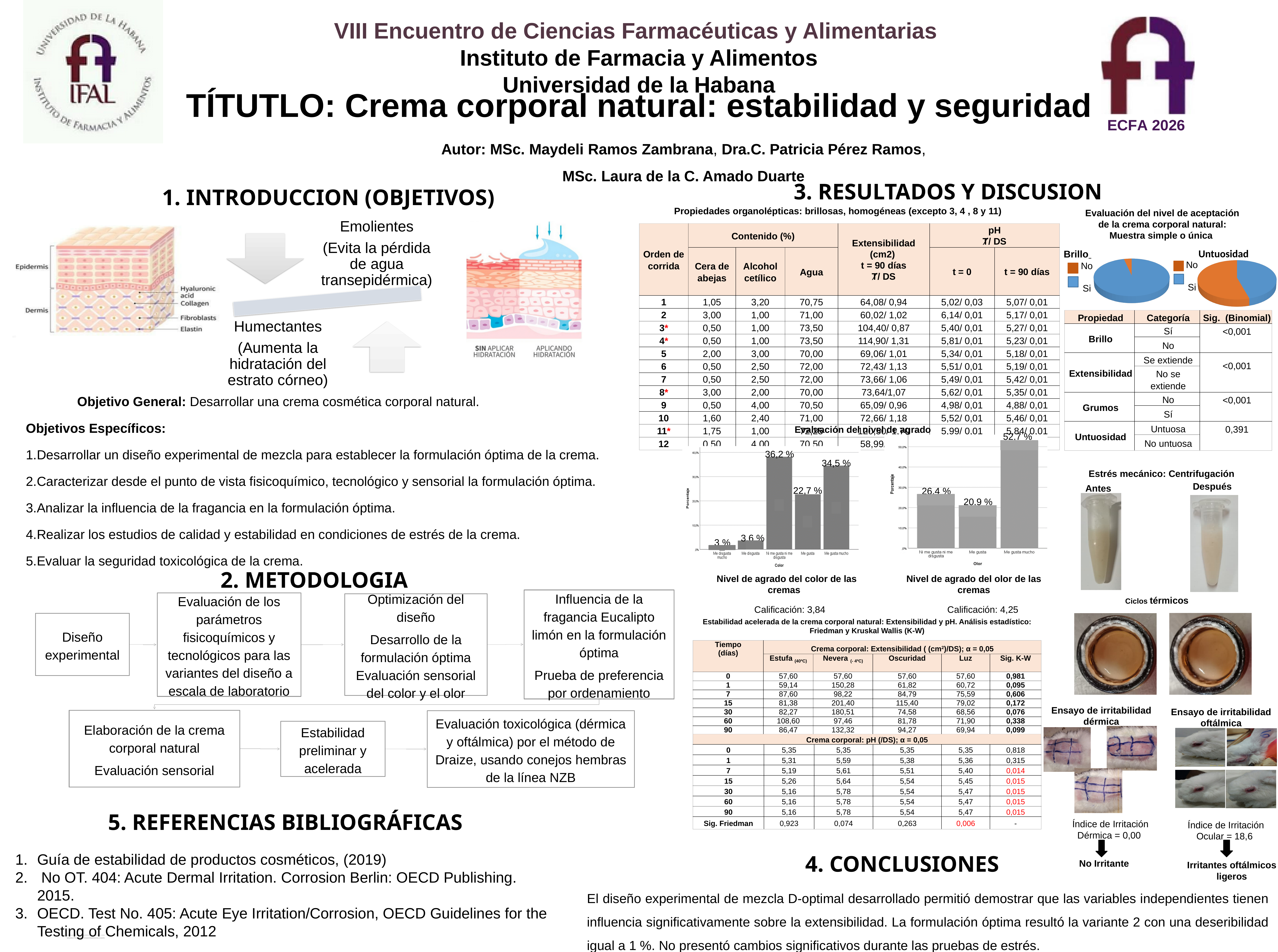
How many categories are shown in the chart 'Nivel de agrado del olor de las cremas'? 3 What kind of chart is 'Nivel de agrado del olor de las cremas'? bar chart In the 'Brillo' pie chart, which slice is larger, 'Si' or 'No'? Si In the chart 'Nivel de agrado del olor de las cremas', is the value for 'Ni me gusta ni me disgusta' larger or smaller than the value for 'Me gusta'? larger How many categories are shown in the chart 'Nivel de agrado del color de las cremas'? 5 In the chart 'Nivel de agrado del color de las cremas', which category has the lowest value? Me disgusta mucho In the chart 'Nivel de agrado del olor de las cremas', what is the value for 'Me gusta mucho'? 52,7 % In the chart 'Nivel de agrado del color de las cremas', what is the difference between 'Me gusta mucho' and 'Me gusta'? 11,8 % In the chart 'Nivel de agrado del color de las cremas', what is the value for 'Me gusta'? 22,7 % In the chart 'Nivel de agrado del color de las cremas', which category has the highest value? Ni me gusta ni me disgusta In the chart 'Nivel de agrado del olor de las cremas', which category has the lowest value? Me gusta In the chart 'Nivel de agrado del color de las cremas', what is the value for 'Ni me gusta ni me disgusta'? 36,2 %